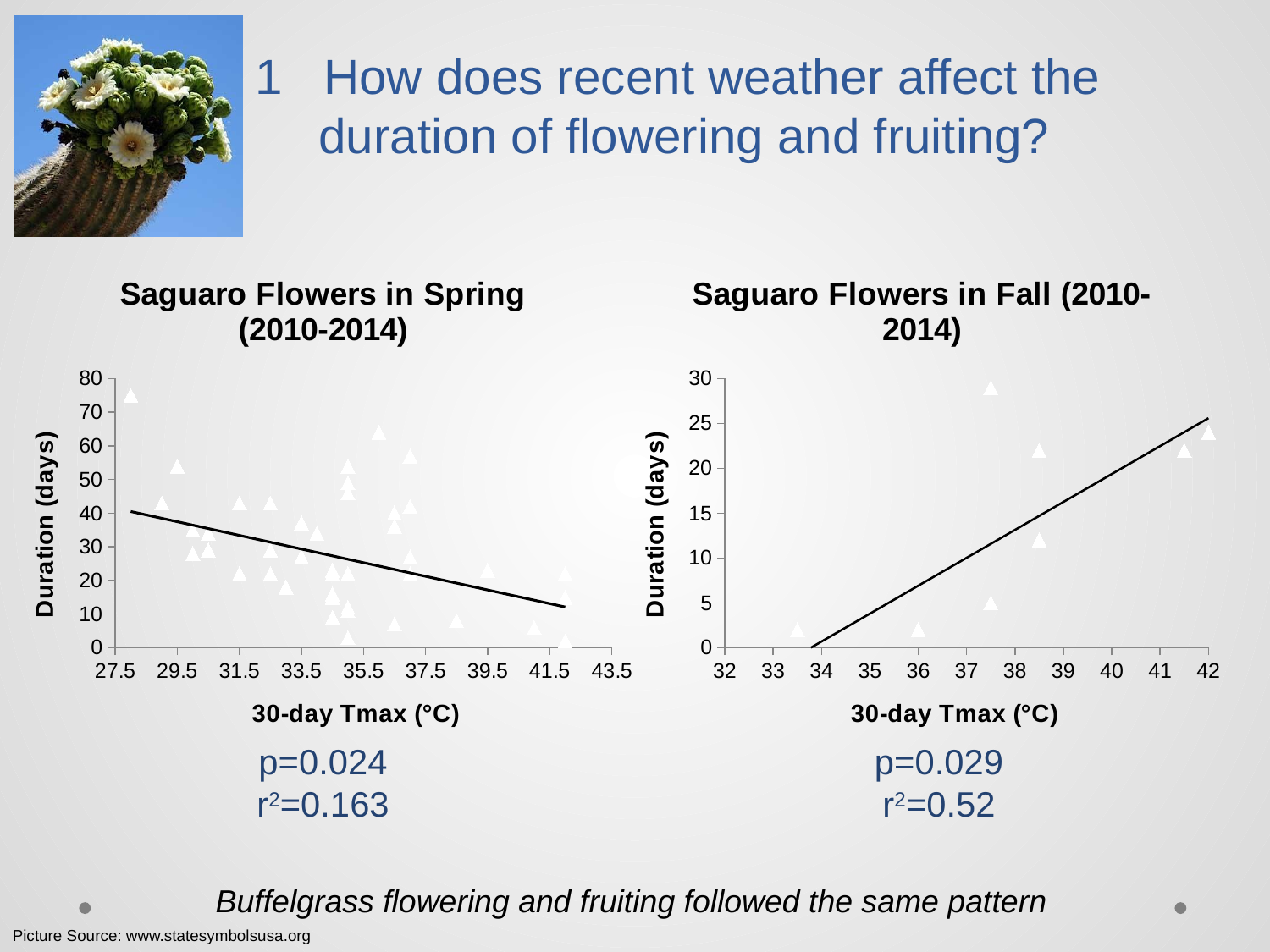
In the Saguaro Flowers in Fall (2010-2014) chart, is the duration of the point at about 36 °C greater or less than 5 days? less What kind of chart is the Saguaro Flowers in Spring (2010-2014) chart? scatter chart Which chart shows a positive relationship between 30-day Tmax and duration, the Spring chart or the Fall chart? the Fall chart In the Saguaro Flowers in Spring (2010-2014) chart, is the highest plotted duration greater or less than 70 days? greater What is the maximum value shown on the y axis of the Saguaro Flowers in Spring (2010-2014) chart? 80 In the Saguaro Flowers in Spring (2010-2014) chart, does the trend line rise or fall as 30-day Tmax increases? fall In the Saguaro Flowers in Fall (2010-2014) chart, does the trend line rise or fall as 30-day Tmax increases? rise In the Saguaro Flowers in Spring (2010-2014) chart, is the duration of the point at about 35.5 °C near the top of the cluster greater or less than 60 days? greater What is the label of the x axis on the Saguaro Flowers in Fall (2010-2014) chart? 30-day Tmax (°C)